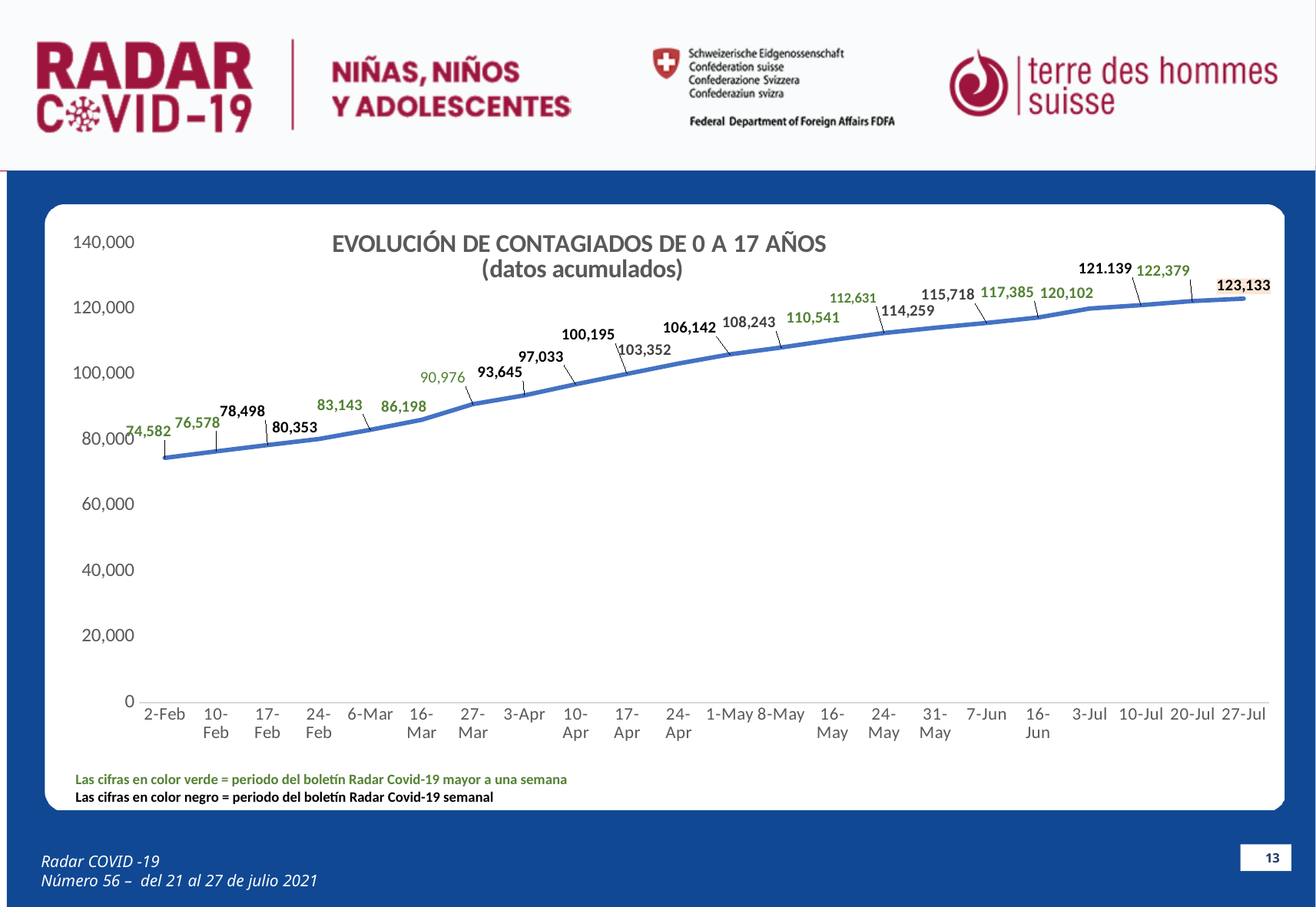
Which is larger, the value for 24-Feb or the value for 6-Mar? 6-Mar What is the value for 16-May? 110,541 Which date has the lowest value? 2-Feb What is the difference between the values for 27-Jul and 2-Feb? 48,551 What is the value for 2-Feb? 74,582 Do the values rise or fall from 2-Feb to 27-Jul? rise How many dates are plotted on the x axis? 22 Which date has the highest value? 27-Jul What is the title of the chart? EVOLUCIÓN DE CONTAGIADOS DE 0 A 17 AÑOS (datos acumulados) What is the value for 17-Apr? 100,195 What is the value for 27-Jul? 123,133 What type of chart is shown on the slide? line chart